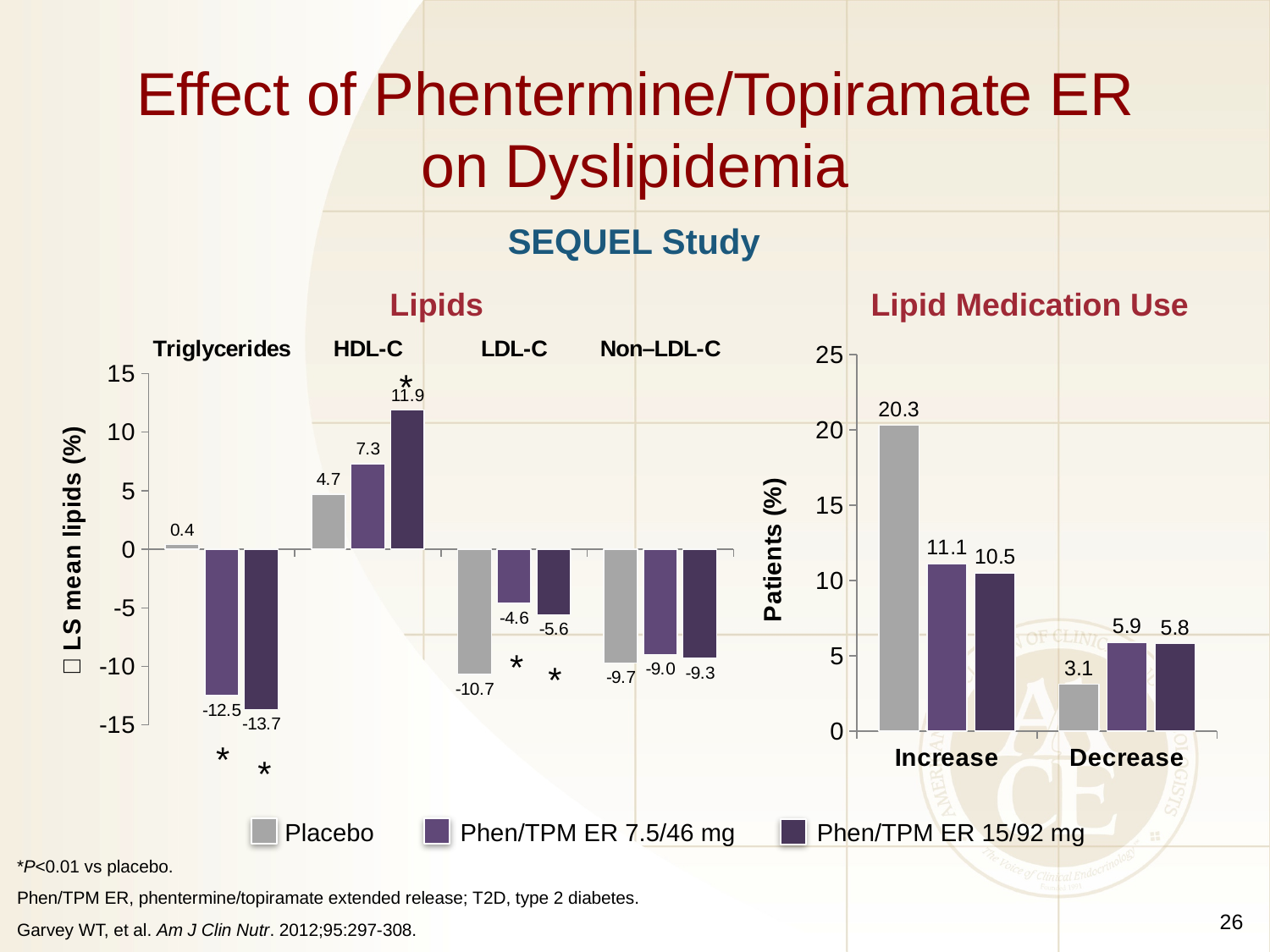
In the Lipids chart, what is the LS mean change in HDL-C for Phen/TPM ER 15/92 mg? 11.9 In the Lipid Medication Use chart, what percentage of placebo patients had an increase in lipid medication? 20.3 In the Lipids chart, what is the LS mean change in LDL-C for Phen/TPM ER 7.5/46 mg? -4.6 How many series does the legend list? 3 What type of chart is the Lipid Medication Use chart? Bar chart In the Lipid Medication Use chart, what percentage of Phen/TPM ER 7.5/46 mg patients had a decrease in lipid medication? 5.9 In the Lipids chart, which treatment group has the largest increase in HDL-C? Phen/TPM ER 15/92 mg In the Lipids chart, how many lipid categories are shown on the x axis? 4 In the Lipid Medication Use chart, which group has the lowest percentage of patients with a decrease in lipid medication? Placebo In the Lipids chart, what is the LS mean change in triglycerides for placebo? 0.4 In the Lipid Medication Use chart, what is the difference between the Increase values for placebo and Phen/TPM ER 15/92 mg? 9.8 In the Lipids chart, what is the difference between the HDL-C values for Phen/TPM ER 15/92 mg and placebo? 7.2